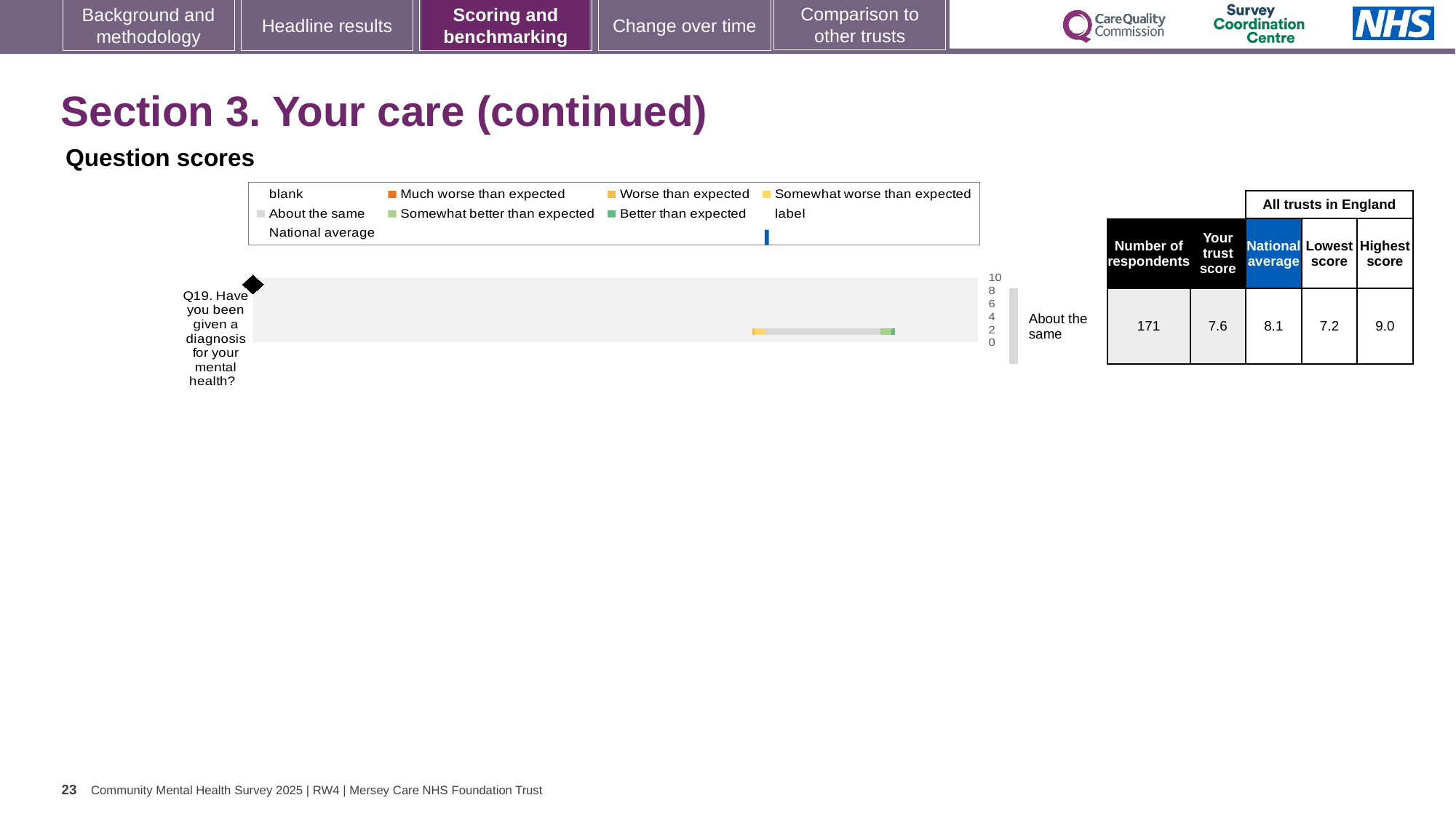
What is the difference between the highest and lowest scores for Q19 across all trusts in England? 1.8 How many respondents answered Q19? 171 What benchmark category is the trust's Q19 score placed in? About the same Which question is plotted in the question scores chart? Q19. Have you been given a diagnosis for your mental health? What is the highest score among all trusts in England for Q19? 9.0 What is the national average score for Q19? 8.1 What is the trust's score for Q19 shown in the table next to the chart? 7.6 By how much does the national average exceed the trust's score for Q19? 0.5 How many questions are plotted in the question scores chart? 1 What kind of chart is used to show the question scores on this slide? bar chart Which is larger for Q19, the trust's score or the national average? National average What is the lowest score among all trusts in England for Q19? 7.2